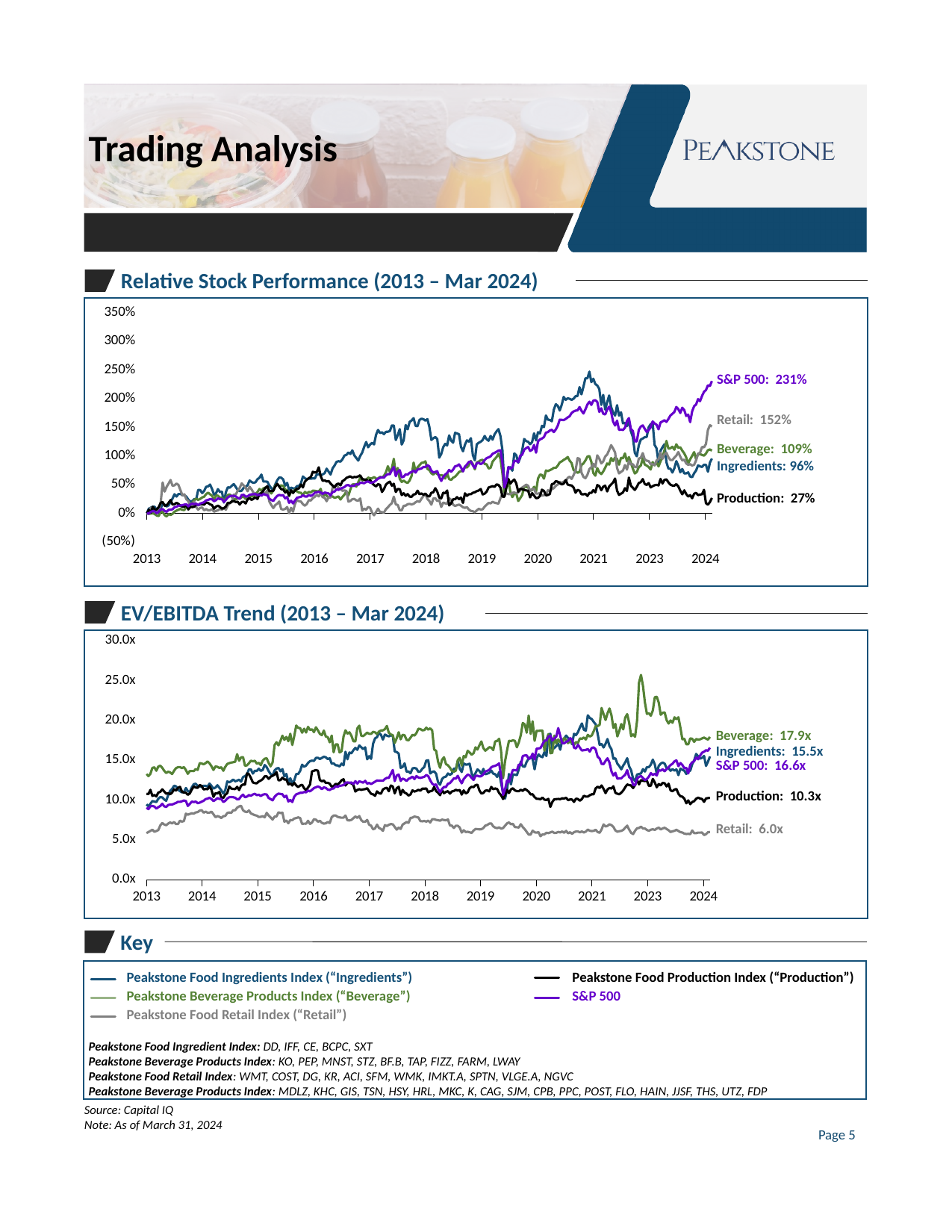
In the Relative Stock Performance chart, does the S&P 500 line generally rise or fall from 2013 to 2024? rise In the EV/EBITDA Trend chart, which index has the lowest value at the end of the period? Retail In the EV/EBITDA Trend chart, what is the final value shown for Beverage? 17.9x What type of chart is the Relative Stock Performance chart? line chart In the EV/EBITDA Trend chart, what is the difference between the end values of Beverage and Retail? 11.9x In the EV/EBITDA Trend chart, which has the larger end value, Ingredients or the S&P 500? S&P 500 In the Relative Stock Performance chart, which index has the lowest value at the end of the period? Production In the Relative Stock Performance chart, which index has the highest value at the end of the period? S&P 500 How many series does the Key list for the charts? 5 In the Relative Stock Performance chart, what is the difference between the end values of the S&P 500 and Retail? 79% In the Relative Stock Performance chart, what is the final value shown for the S&P 500? 231% In the EV/EBITDA Trend chart, which series has the highest value at the end of the period? Beverage